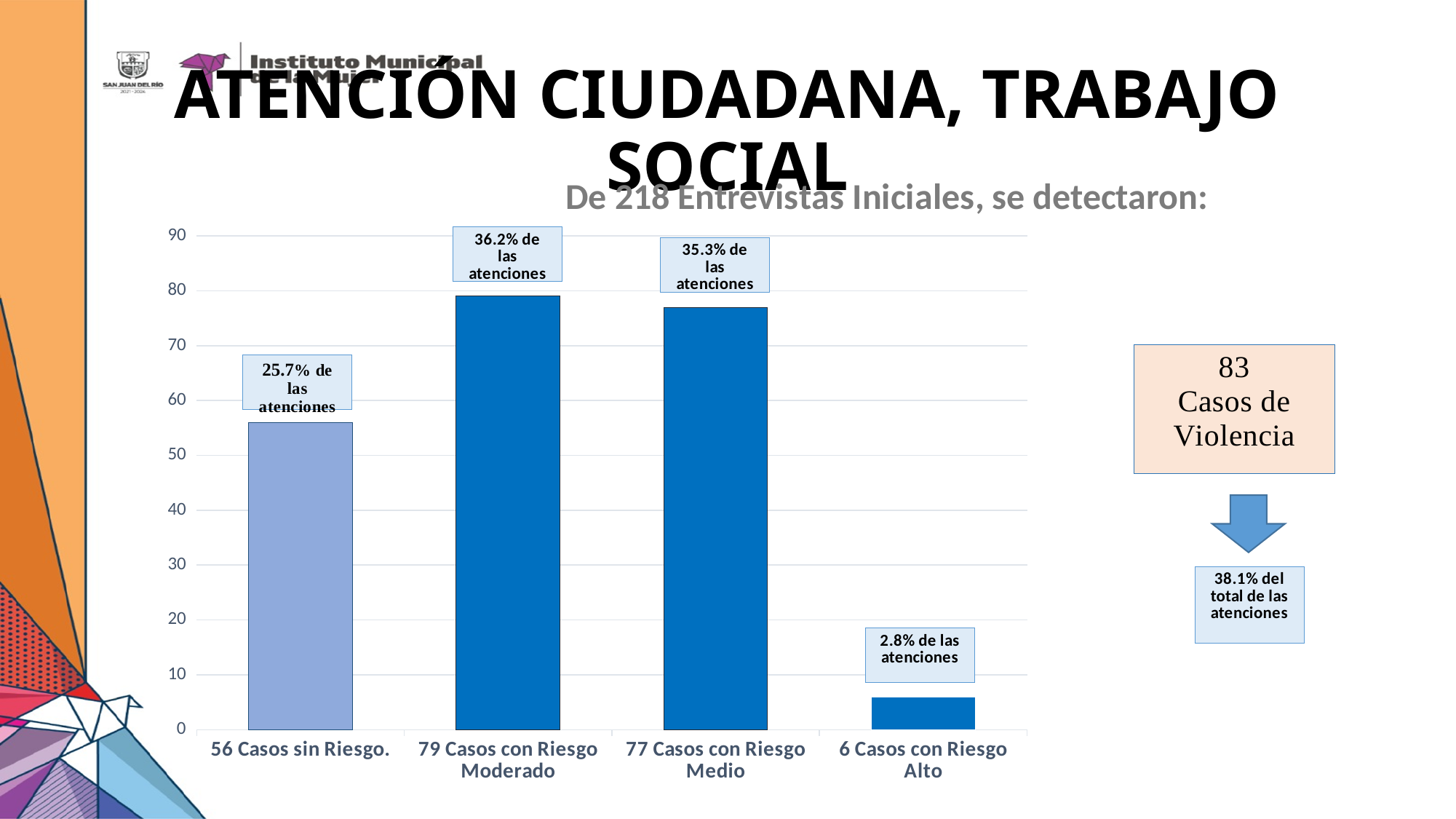
Which has more cases: 'Casos sin Riesgo' or 'Casos con Riesgo Medio'? 77 Casos con Riesgo Medio How many cases are shown for 'Casos con Riesgo Moderado'? 79 What is the difference in cases between 'Casos con Riesgo Moderado' and 'Casos con Riesgo Medio'? 2 What percentage of the atenciones do the 'Casos sin Riesgo' represent, according to the label above the bar? 25.7% de las atenciones Which category has the lowest number of cases? 6 Casos con Riesgo Alto What type of chart is shown on the slide? bar chart What is the title of the chart? De 218 Entrevistas Iniciales, se detectaron: How many cases are shown for 'Casos con Riesgo Alto'? 6 Which category has the highest number of cases? 79 Casos con Riesgo Moderado How many categories (bars) does the chart show? 4 What is the difference in cases between 'Casos sin Riesgo' and 'Casos con Riesgo Alto'? 50 What percentage of the atenciones do the 'Casos con Riesgo Medio' represent, according to the label above the bar? 35.3% de las atenciones